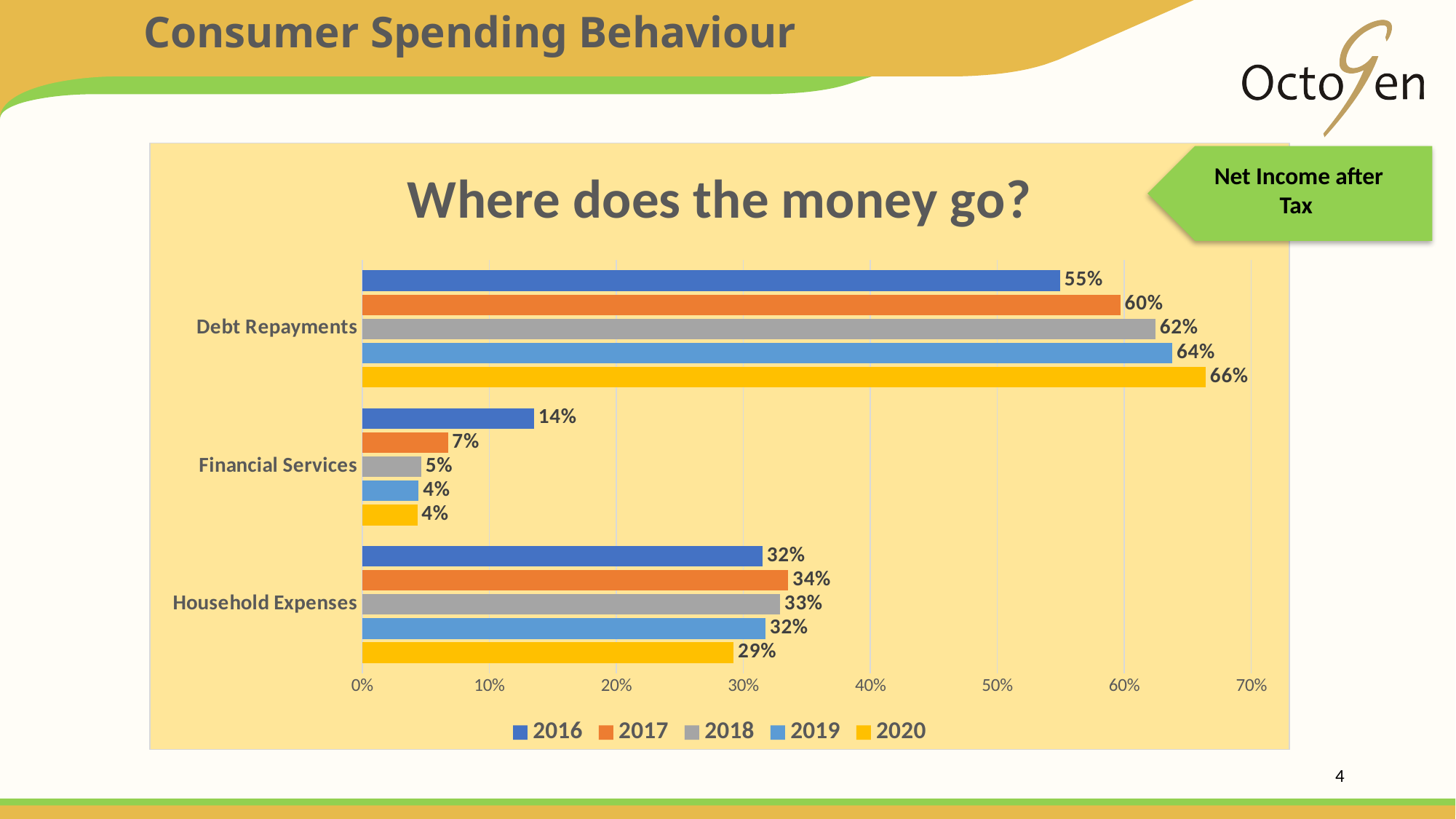
Which is larger for Household Expenses: the 2017 value or the 2020 value? 2017 Is the 2017 value for Debt Repayments greater or less than 50%? greater What is the difference between the 2020 and 2016 values for Debt Repayments? 11% What is the value for Debt Repayments in 2020? 66% Which category has the highest value in 2019? Debt Repayments Which category has the lowest value in 2018? Financial Services What is the value for Financial Services in 2016? 14% How many categories are shown on the chart? 3 How many series does the legend list? 5 What is the title of the chart? Where does the money go? What is the value for Household Expenses in 2017? 34% What kind of chart is shown on the slide? Bar chart